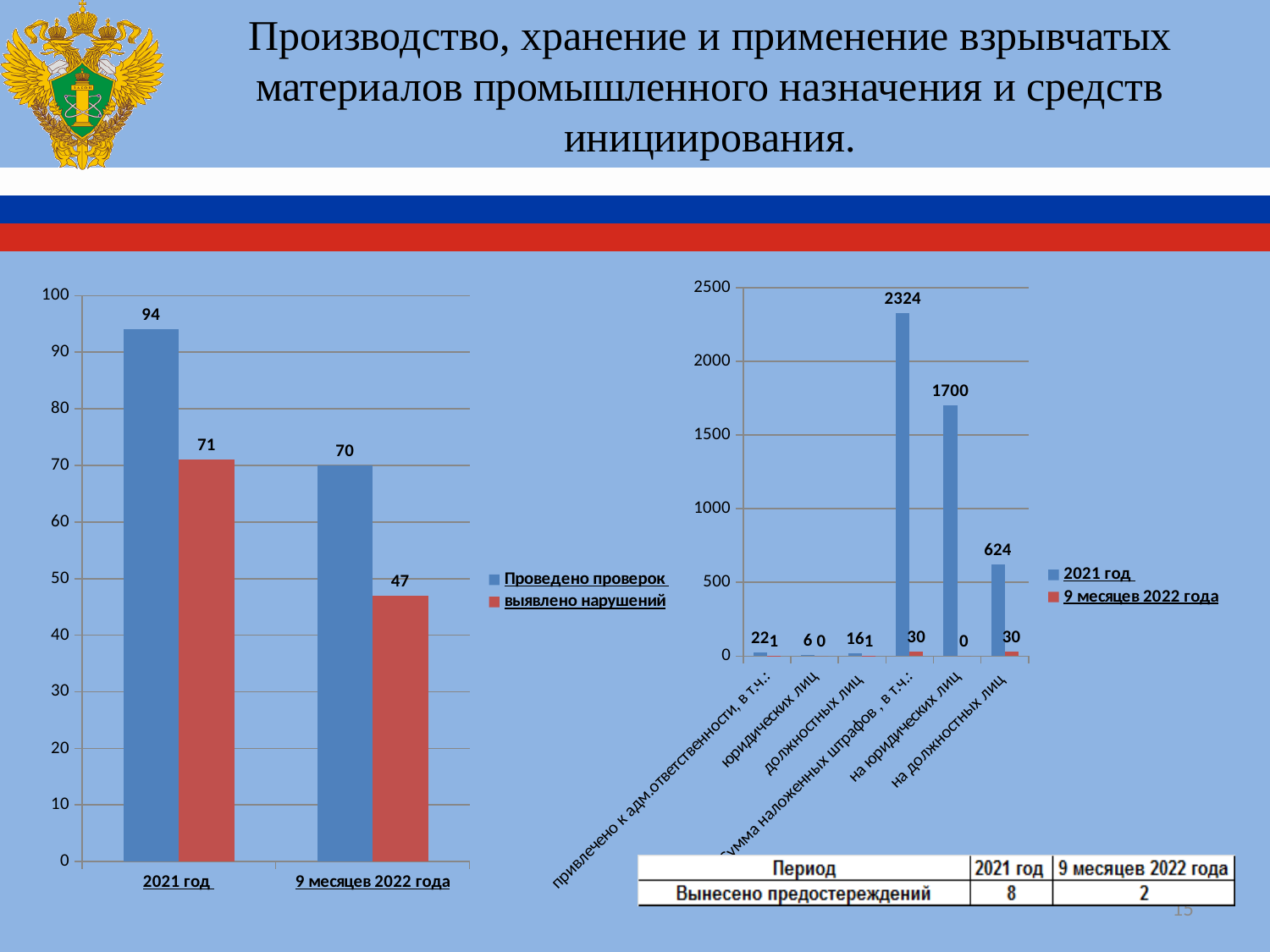
In the left chart, what is the value of 'Проведено проверок' for '2021 год'? 94 In the left chart, what is the difference between 'Проведено проверок' and 'выявлено нарушений' for '2021 год'? 23 In the left chart, does the value of 'Проведено проверок' rise or fall from '2021 год' to '9 месяцев 2022 года'? fall In the right chart, what is the difference between the '2021 год' values for 'на юридических лиц' and 'на должностных лиц'? 1076 In the right chart, what is the value for 'сумма наложенных штрафов, в т.ч.:' in '2021 год'? 2324 What kind of chart is the left chart? bar chart In the right chart, which is larger for '2021 год': 'на юридических лиц' or 'на должностных лиц'? на юридических лиц In the right chart, what is the value for 'на должностных лиц' in '9 месяцев 2022 года'? 30 In the left chart, what is the value of 'выявлено нарушений' for '9 месяцев 2022 года'? 47 In the left chart, how many series does the legend list? 2 In the right chart, how many categories are shown on the x axis? 6 In the right chart, which category has the highest value for '2021 год'? сумма наложенных штрафов, в т.ч.: